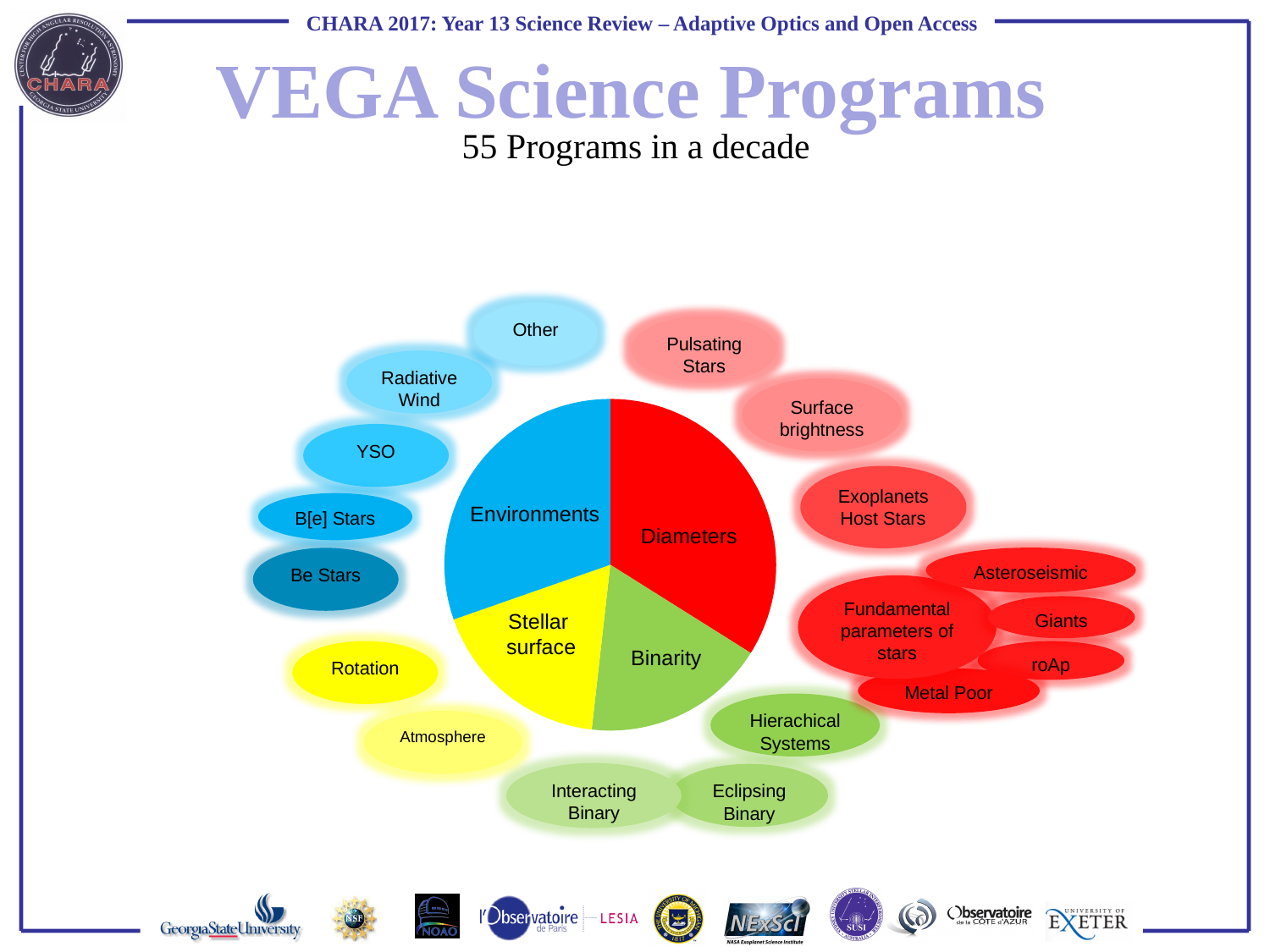
What colour is the Diameters slice of the pie chart? red Which slice is larger, Environments or Stellar surface? Environments Which slice is larger, Diameters or Binarity? Diameters How many slices does the pie chart have? 4 What is the title of the slide containing the pie chart? VEGA Science Programs Which slice is larger, Environments or Binarity? Environments What kind of chart is shown on the slide? pie chart